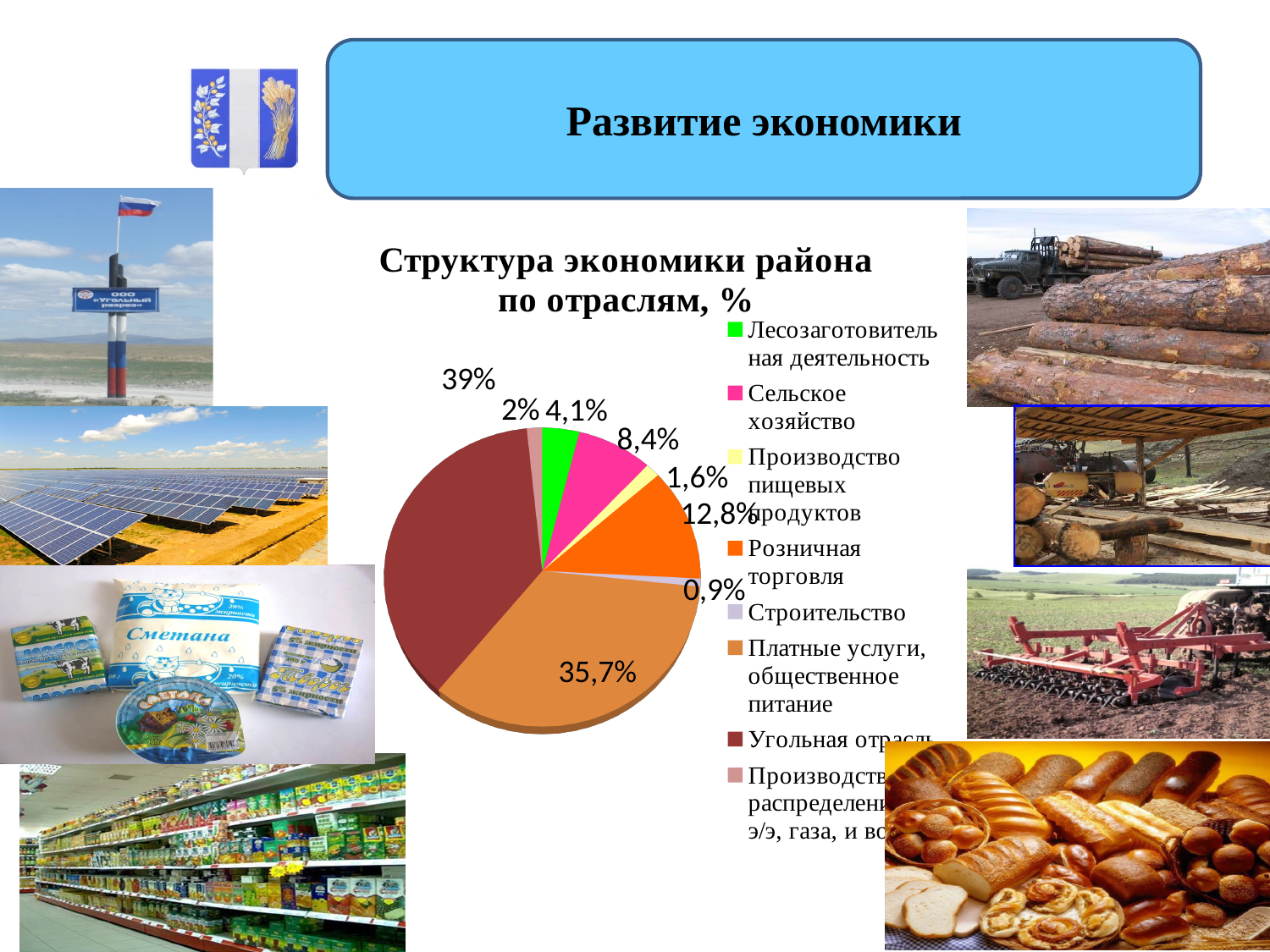
What kind of chart is shown on the slide? pie chart What share does Лесозаготовительная деятельность have in the pie chart? 4,1% What share does Платные услуги, общественное питание have in the pie chart? 35,7% Which sector has the largest share in the pie chart? Угольная отрасль What share does Строительство have in the pie chart? 0,9% What is the title of the chart? Структура экономики района по отраслям, % What share does Розничная торговля have in the pie chart? 12,8% What share does Сельское хозяйство have in the pie chart? 8,4% By how many percentage points does Угольная отрасль exceed Платные услуги, общественное питание? 3,3 What share does Угольная отрасль have in the pie chart? 39% Which has a larger share: Розничная торговля or Сельское хозяйство? Розничная торговля Which sector has the smallest share in the pie chart? Строительство